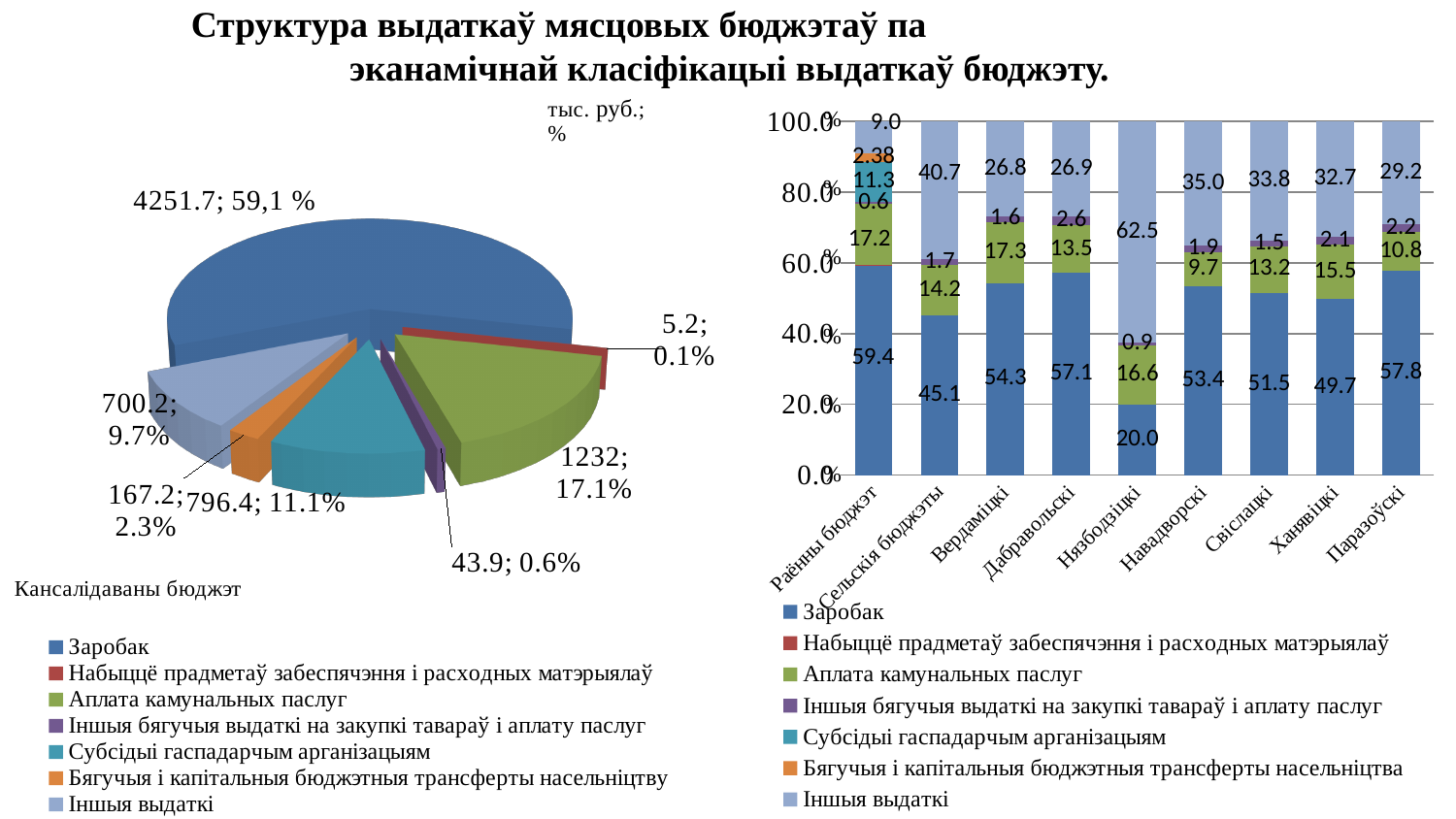
In the pie chart on the left, how many slices are there? 7 In the pie chart on the left, which category has the smallest slice? Набыццё прадметаў забеспячэння і расходных матэрыялаў In the pie chart on the left, what value is shown for Субсідыі гаспадарчым арганізацыям? 796.4; 11.1% In the stacked bar chart on the right, what is the Іншыя выдаткі value for Сельскія бюджэты? 40.7 In the pie chart on the left, what value is shown for the Заробак slice? 4251.7; 59,1 % In the stacked bar chart on the right, what is the Заробак value for Нязбодзіцкі? 20.0 In the pie chart on the left, what percentage share does the Аплата камунальных паслуг slice have? 17.1% In the stacked bar chart on the right, how many categories are shown on the x axis? 9 In the stacked bar chart on the right, which category has the highest Іншыя выдаткі value? Нязбодзіцкі In the stacked bar chart on the right, which category has the lowest Заробак value? Нязбодзіцкі In the stacked bar chart on the right, what is the difference between the Заробак values for Раённы бюджэт and Сельскія бюджэты? 14.3 In the stacked bar chart on the right, how many series does the legend list? 7